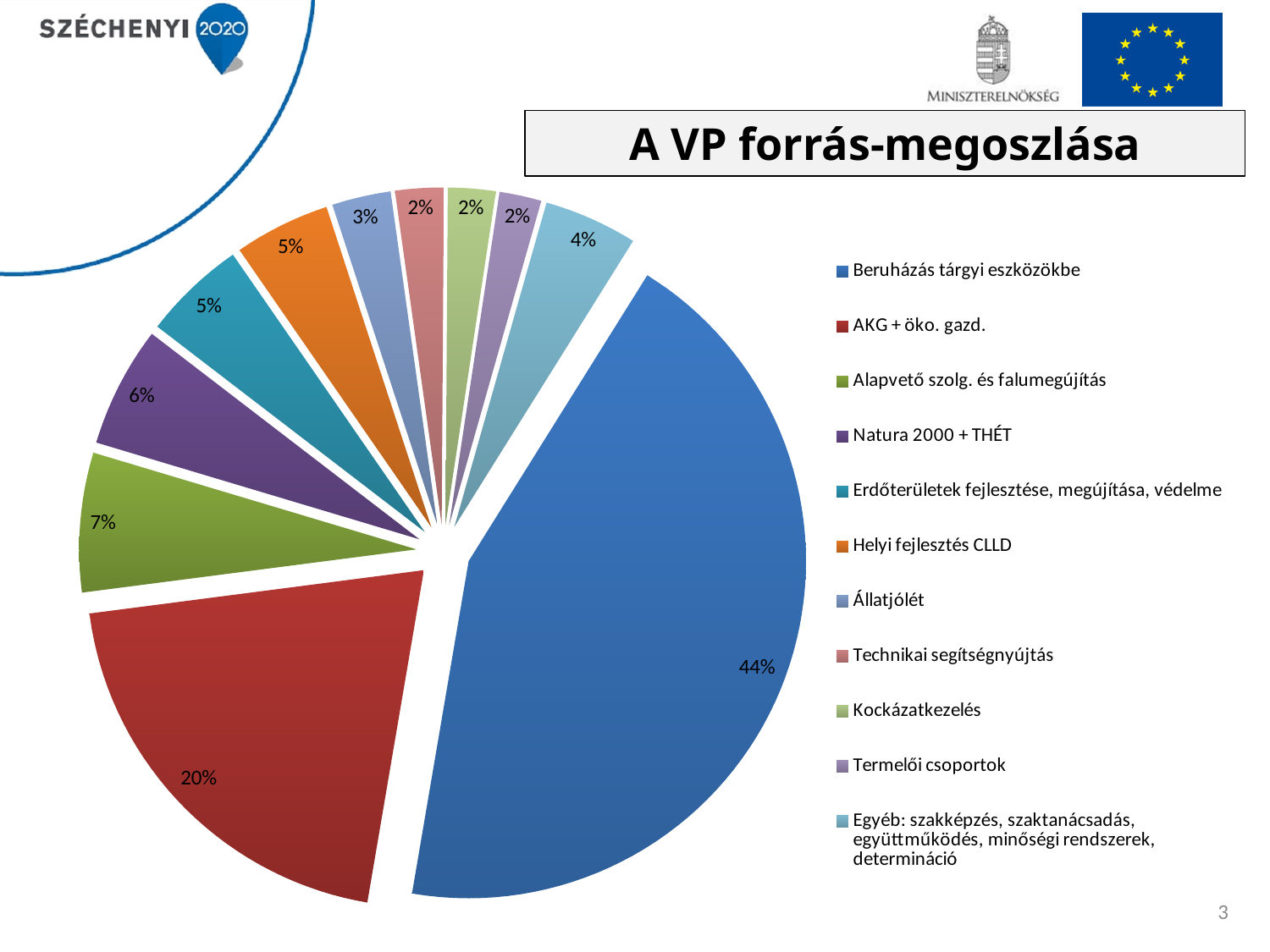
What is the value shown for the 'Egyéb: szakképzés, szaktanácsadás, együttműködés, minőségi rendszerek, determináció' slice? 4% What share of the pie does 'Beruházás tárgyi eszközökbe' take? 44% Which is larger, the slice for 'Helyi fejlesztés CLLD' or the slice for 'Állatjólét'? Helyi fejlesztés CLLD What is the title of the chart? A VP forrás-megoszlása How many slices does the pie chart have? 11 What is the value shown for 'Állatjólét'? 3% What is the value shown for 'Natura 2000 + THÉT'? 6% What is the value shown for 'Alapvető szolg. és falumegújítás'? 7% What is the value shown for 'AKG + öko. gazd.'? 20% What kind of chart is shown on the slide? pie chart What is the difference between the 'Beruházás tárgyi eszközökbe' slice and the 'AKG + öko. gazd.' slice? 24% Which category has the largest slice of the pie? Beruházás tárgyi eszközökbe